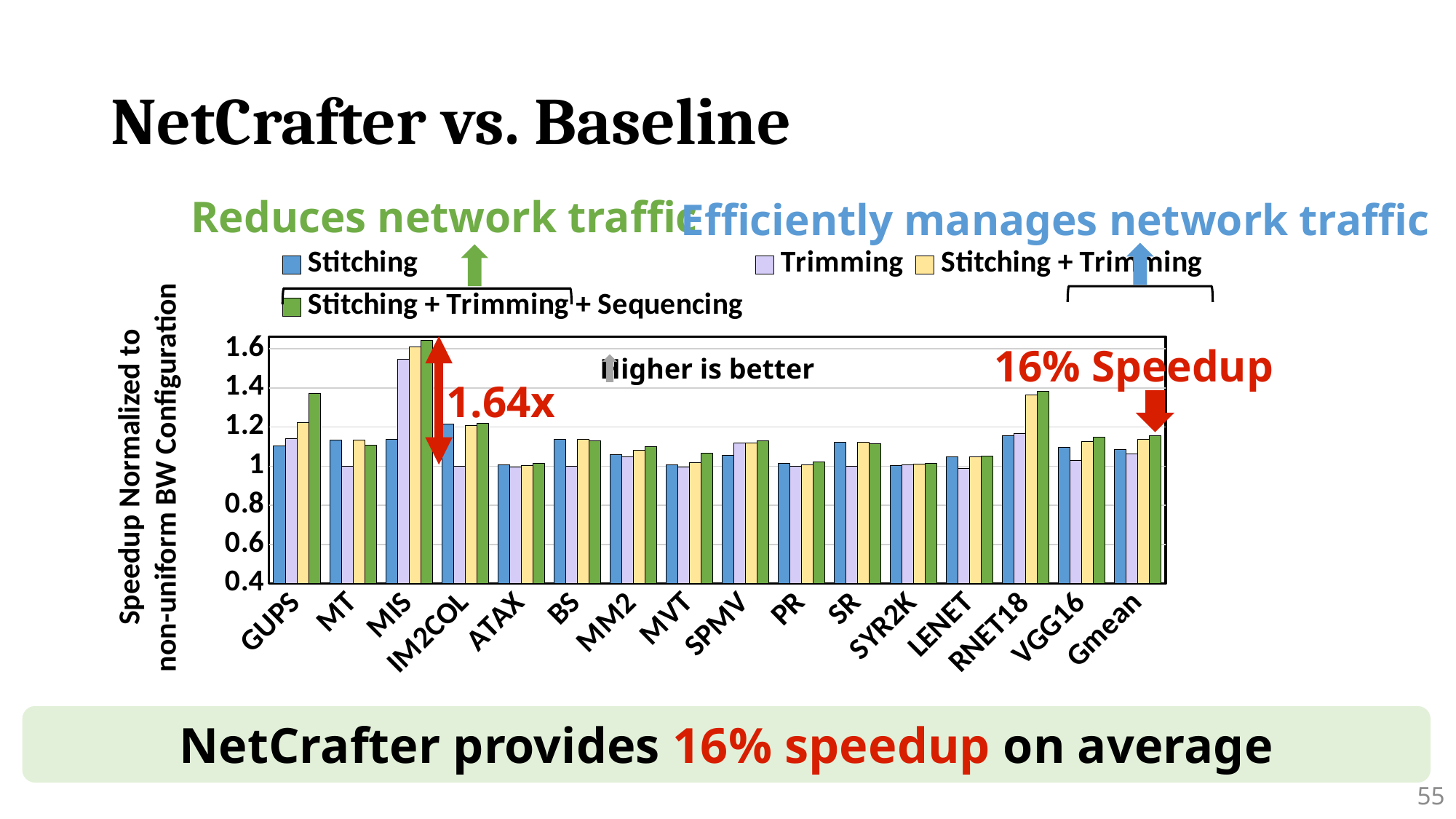
How many categories are shown along the x axis of the chart? 16 Is the Stitching + Trimming + Sequencing value for GUPS greater or less than 1.2? greater Which category has the highest Stitching + Trimming + Sequencing bar? MIS What speedup value is annotated in red next to the MIS bars? 1.64x What kind of chart is shown on the slide? bar chart Is the Trimming value for MIS greater or less than 1.4? greater Is the Stitching + Trimming + Sequencing value for ATAX greater or less than 1.2? less How many series does the chart's legend list? 4 Which is larger, the Stitching + Trimming + Sequencing value for MIS or for ATAX? MIS What is the label of the chart's y axis? Speedup Normalized to non-uniform BW Configuration